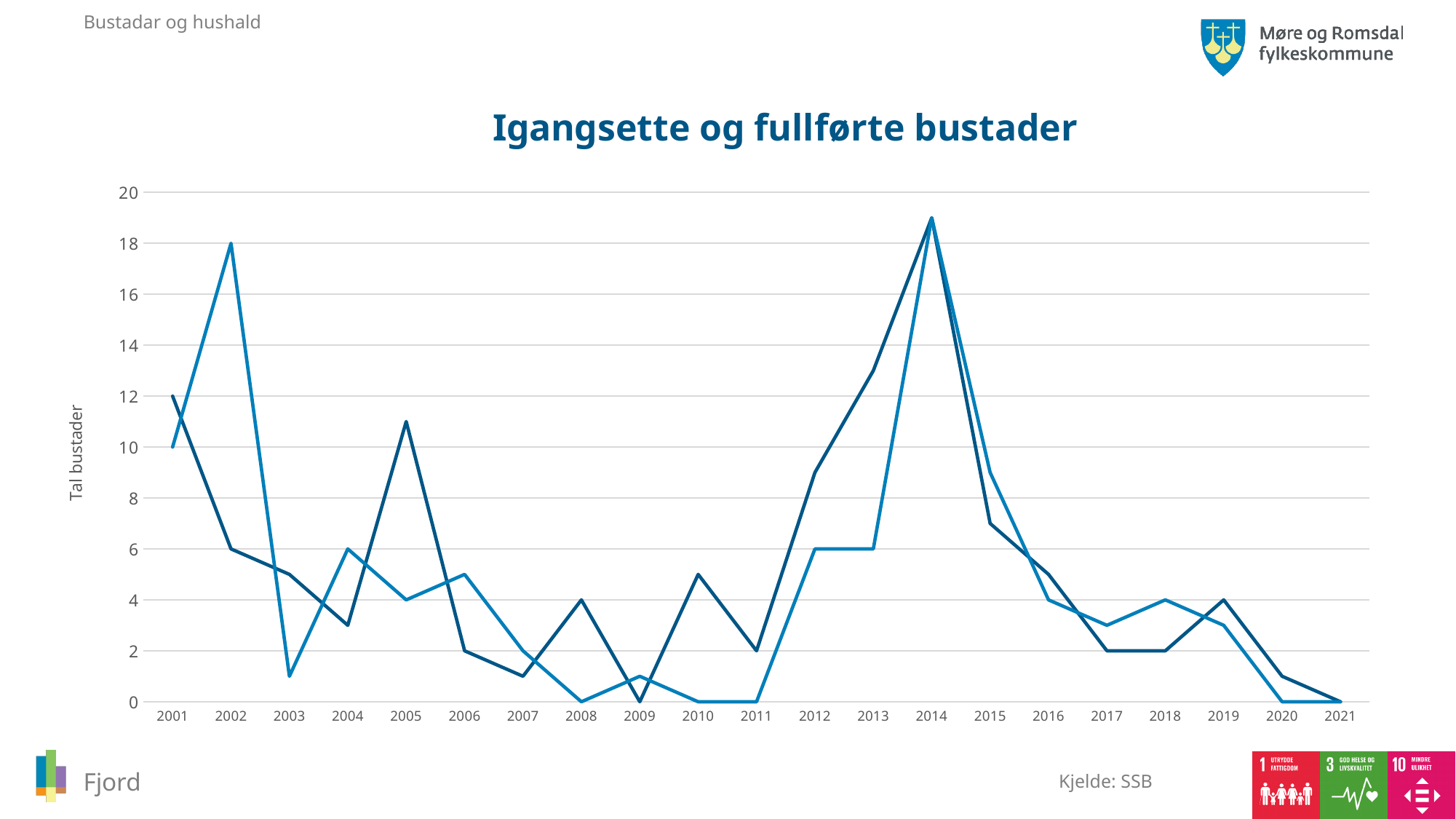
What is the difference between the lighter blue line (18) and the darker blue line (6) in 2002? 12 What is the label on the vertical axis? Tal bustader Is the peak value in 2014 greater or less than 18? greater How many years are shown along the x axis? 21 What is the value of the lighter blue line in 2002? 18 From 2014 to 2021, do the values generally rise or fall? fall In 2002, which line is higher, the lighter blue or the darker blue? the lighter blue line What kind of chart is shown on the slide? line chart What is the title of the chart? Igangsette og fullførte bustader What is the value of the darker blue line in 2001? 12 How many lines are plotted on the chart? 2 In which year do both lines reach their highest value? 2014